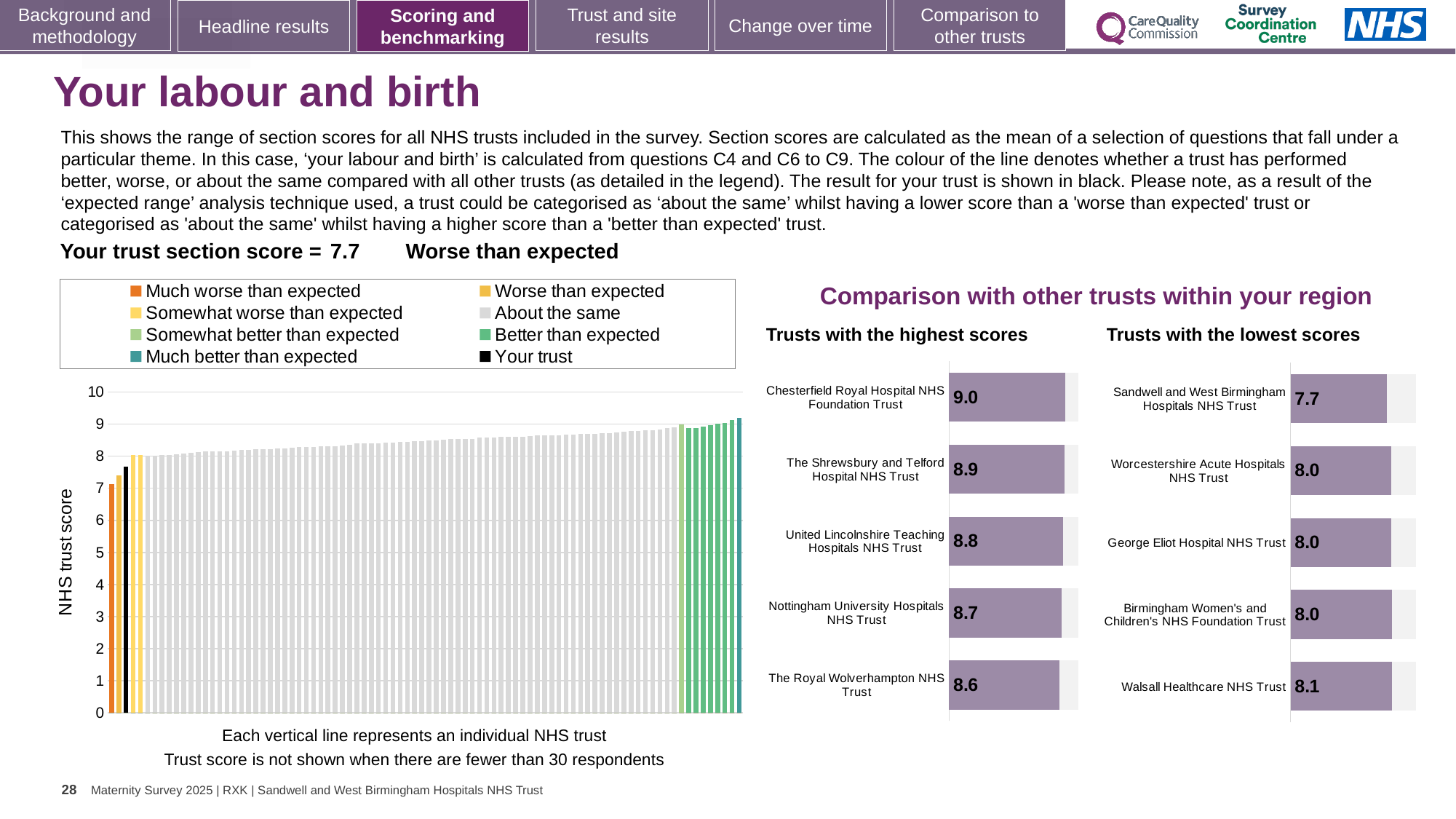
In the 'NHS trust score' chart, do the bar values rise or fall from left to right? Rise In the 'Trusts with the lowest scores' chart, what is the difference between the scores of Walsall Healthcare NHS Trust and Sandwell and West Birmingham Hospitals NHS Trust? 0.4 In the 'Trusts with the lowest scores' chart, what is the score for Walsall Healthcare NHS Trust? 8.1 In the 'Trusts with the highest scores' chart, what is the score for Chesterfield Royal Hospital NHS Foundation Trust? 9.0 Which is larger: the score for United Lincolnshire Teaching Hospitals NHS Trust in the highest scores chart, or the score for Worcestershire Acute Hospitals NHS Trust in the lowest scores chart? United Lincolnshire Teaching Hospitals NHS Trust How many entries does the legend of the 'NHS trust score' chart list? 8 How many trusts are shown in the 'Trusts with the lowest scores' chart? 5 In the 'Trusts with the lowest scores' chart, which trust has the lowest score? Sandwell and West Birmingham Hospitals NHS Trust In the 'Trusts with the highest scores' chart, what is the difference between the scores of Chesterfield Royal Hospital NHS Foundation Trust and The Royal Wolverhampton NHS Trust? 0.4 In the 'Trusts with the highest scores' chart, which trust has the highest score? Chesterfield Royal Hospital NHS Foundation Trust In the 'Trusts with the highest scores' chart, what is the score for The Royal Wolverhampton NHS Trust? 8.6 What kind of chart is the 'NHS trust score' chart on the left of the slide? Bar chart